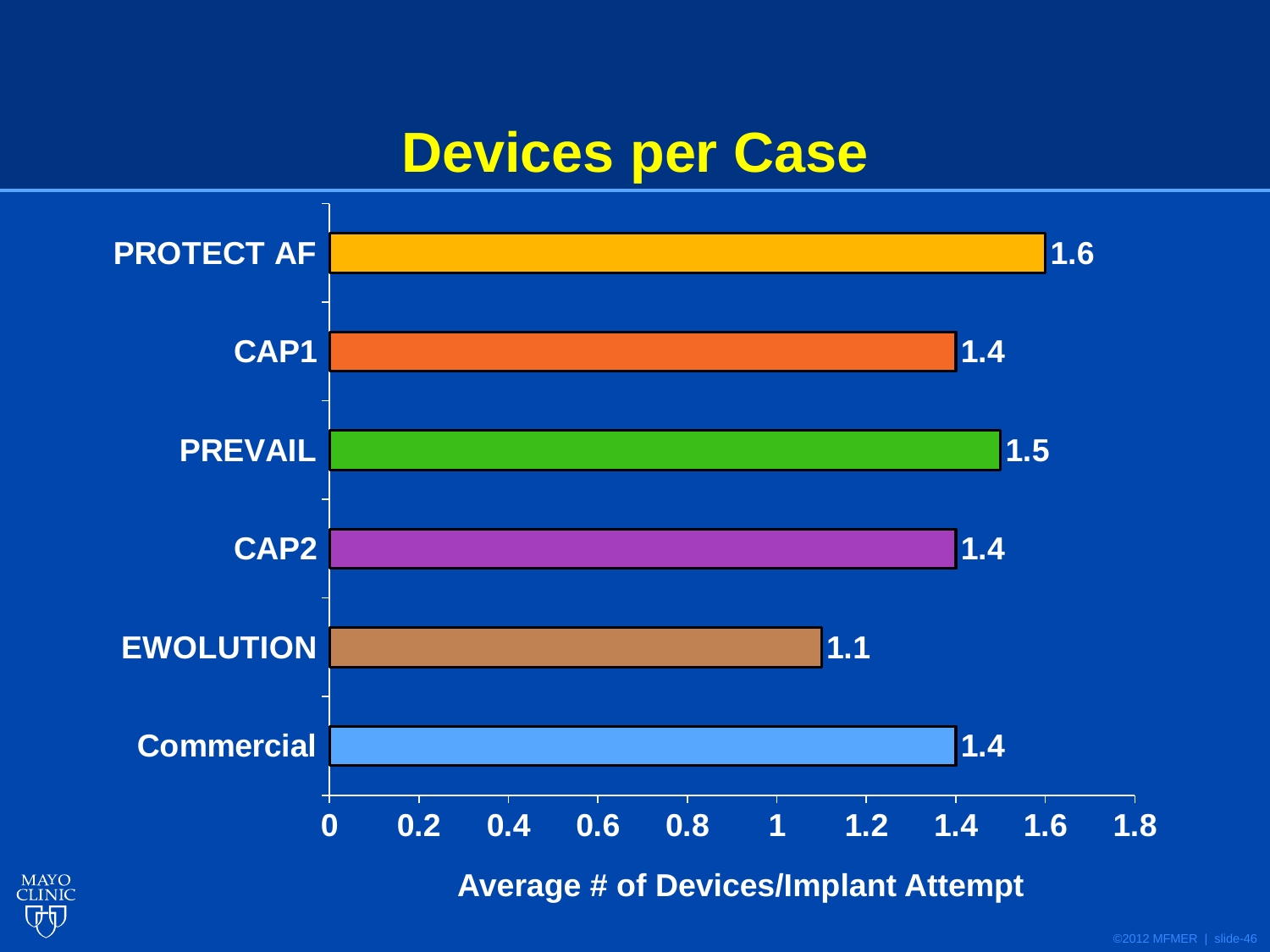
Which is larger, the value for PREVAIL or the value for CAP2? PREVAIL What is the value shown for Commercial? 1.4 What is the difference between the values for PROTECT AF and EWOLUTION? 0.5 How many categories are shown in the chart? 6 What is the title of the chart? Devices per Case Which category has the highest average number of devices per implant attempt? PROTECT AF What is the difference between the values for PREVAIL and CAP1? 0.1 What kind of chart is shown on the slide? Bar chart What is the value shown for PREVAIL? 1.5 Which category has the lowest average number of devices per implant attempt? EWOLUTION What is the average number of devices per implant attempt for PROTECT AF? 1.6 What is the value shown for EWOLUTION? 1.1